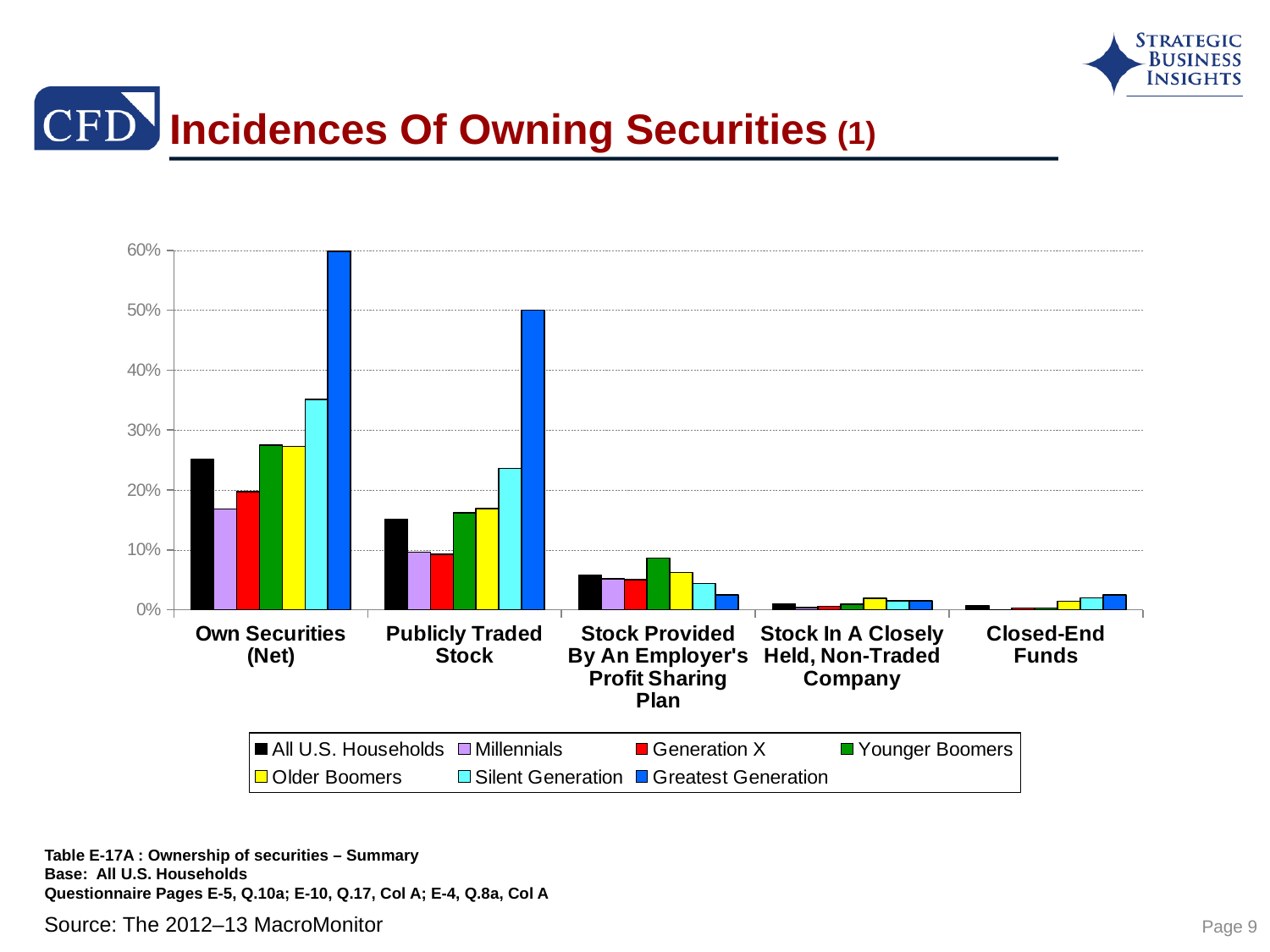
How many categories are shown along the x axis? 5 For Publicly Traded Stock, which is larger: Greatest Generation or All U.S. Households? Greatest Generation What is the title of the slide's chart? Incidences Of Owning Securities (1) Which series has the lowest bar for Own Securities (Net)? Millennials Is the value for Greatest Generation in Publicly Traded Stock greater or less than 40%? greater How many series does the legend list? 7 Is the value for Greatest Generation in Own Securities (Net) greater or less than 50%? greater Is the value for All U.S. Households in Own Securities (Net) greater or less than 20%? greater What kind of chart is shown on the slide? bar chart For Own Securities (Net), which is larger: Silent Generation or Millennials? Silent Generation Which series has the highest bar for Own Securities (Net)? Greatest Generation